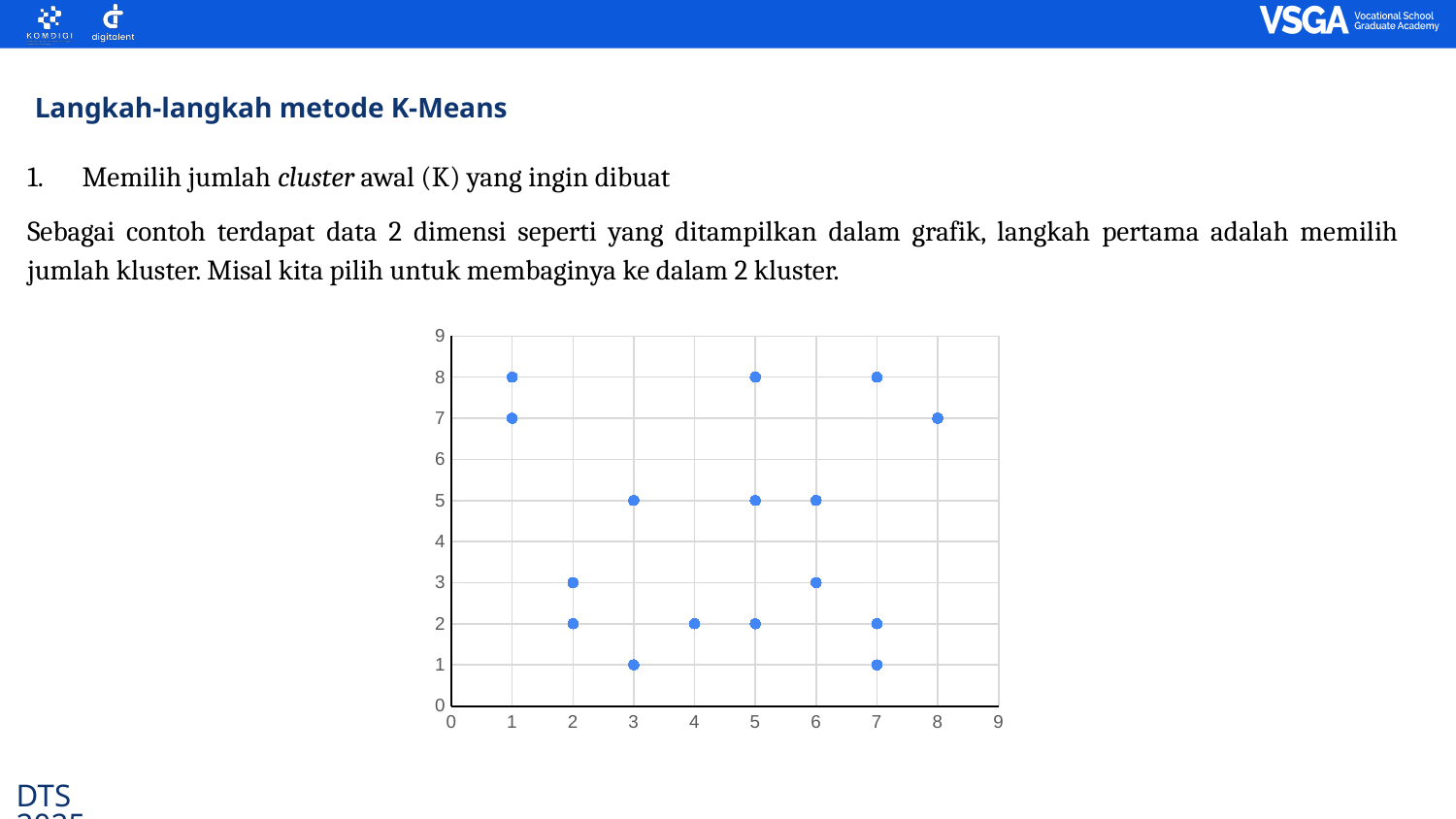
What is the y value of the point plotted at x = 8? 7 What is the maximum value shown on the y axis? 9 What kind of chart is shown on the slide? Scatter plot What is the lowest y value among the plotted points? 1 What is the highest y value reached by any plotted point? 8 How many points are plotted at x = 7? 3 What is the largest x value among the plotted points? 8 What is the difference between the highest and lowest y values of the plotted points? 7 How many points are plotted at y = 8? 3 Is the y value of the point at x = 8 greater or less than 5? greater